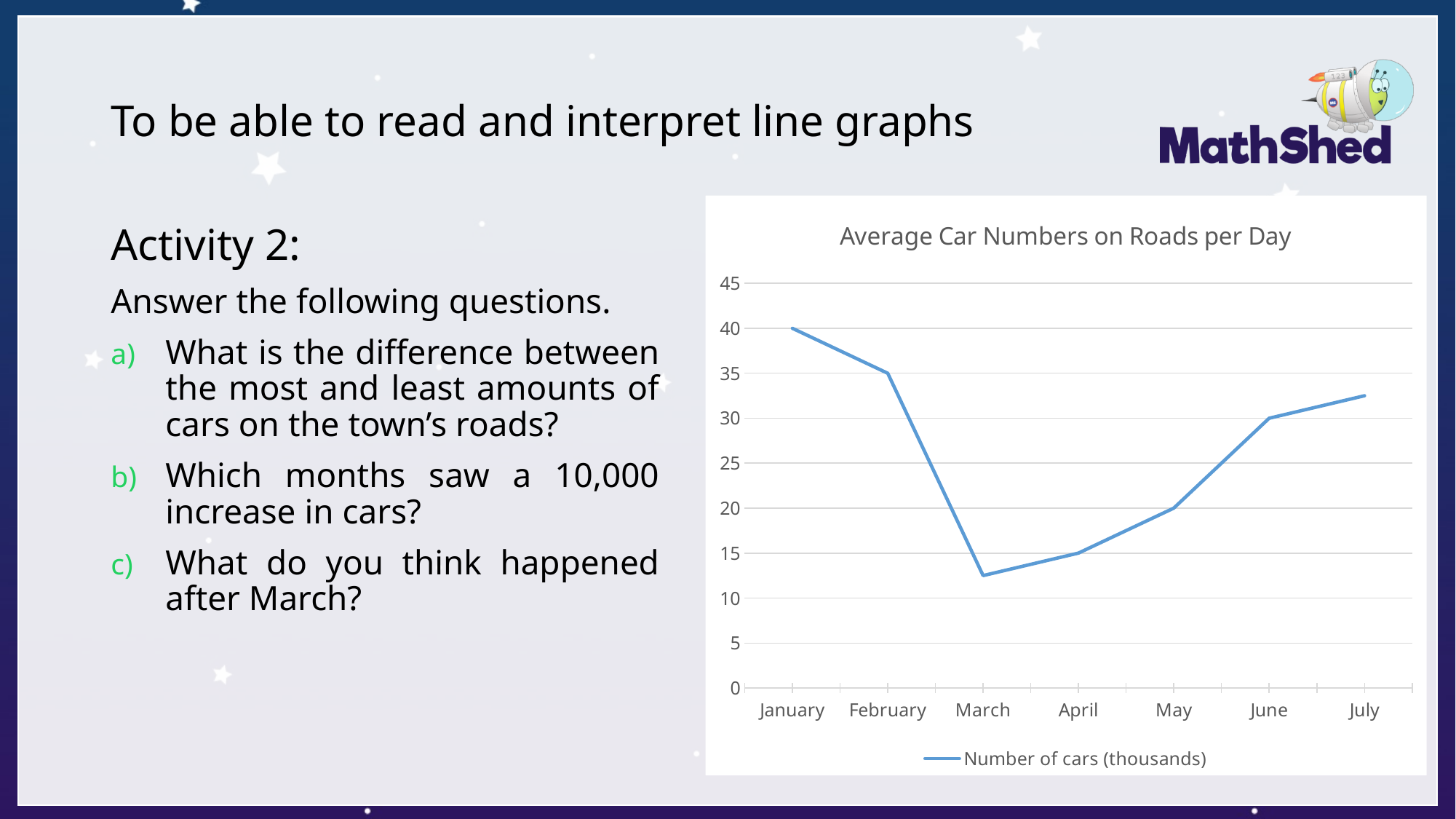
How many series does the chart's legend list? 1 Is the value for March greater or less than 15? less What is the value for May? 20 What is the value for June? 30 Which month has the highest value? January Which month has the lowest value? March What is the difference between the values for January and February? 5 What is the value for February? 35 What is the title of the chart? Average Car Numbers on Roads per Day What kind of chart is shown on the slide? line chart How many months are plotted on the x axis of the chart? 7 What is the value for January? 40